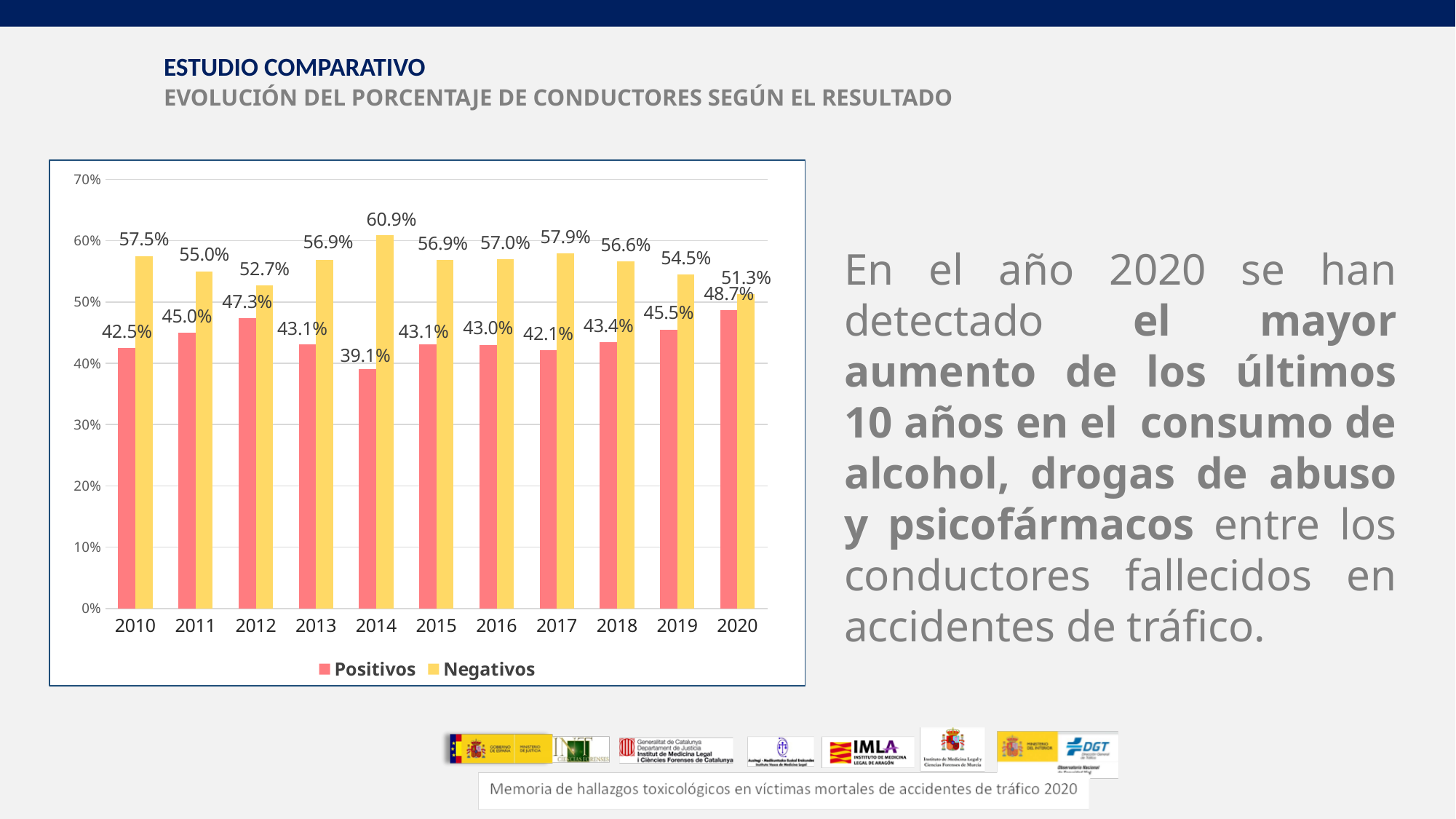
Is the Positivos value for 2014 greater or less than 40%? less In which year is the Negativos value lowest? 2020 How many years are shown on the x axis? 11 What is the Negativos value for 2014? 60.9% What is the Positivos value for 2012? 47.3% What is the difference between the Negativos and Positivos values in 2020? 2.6% How many series does the legend list? 2 What kind of chart is shown on the slide? bar chart What is the Positivos value for 2020? 48.7% In which year is the Positivos value lowest? 2014 In which year is the Negativos value highest? 2014 Which is larger, the Positivos value for 2019 or the Positivos value for 2011? 2019